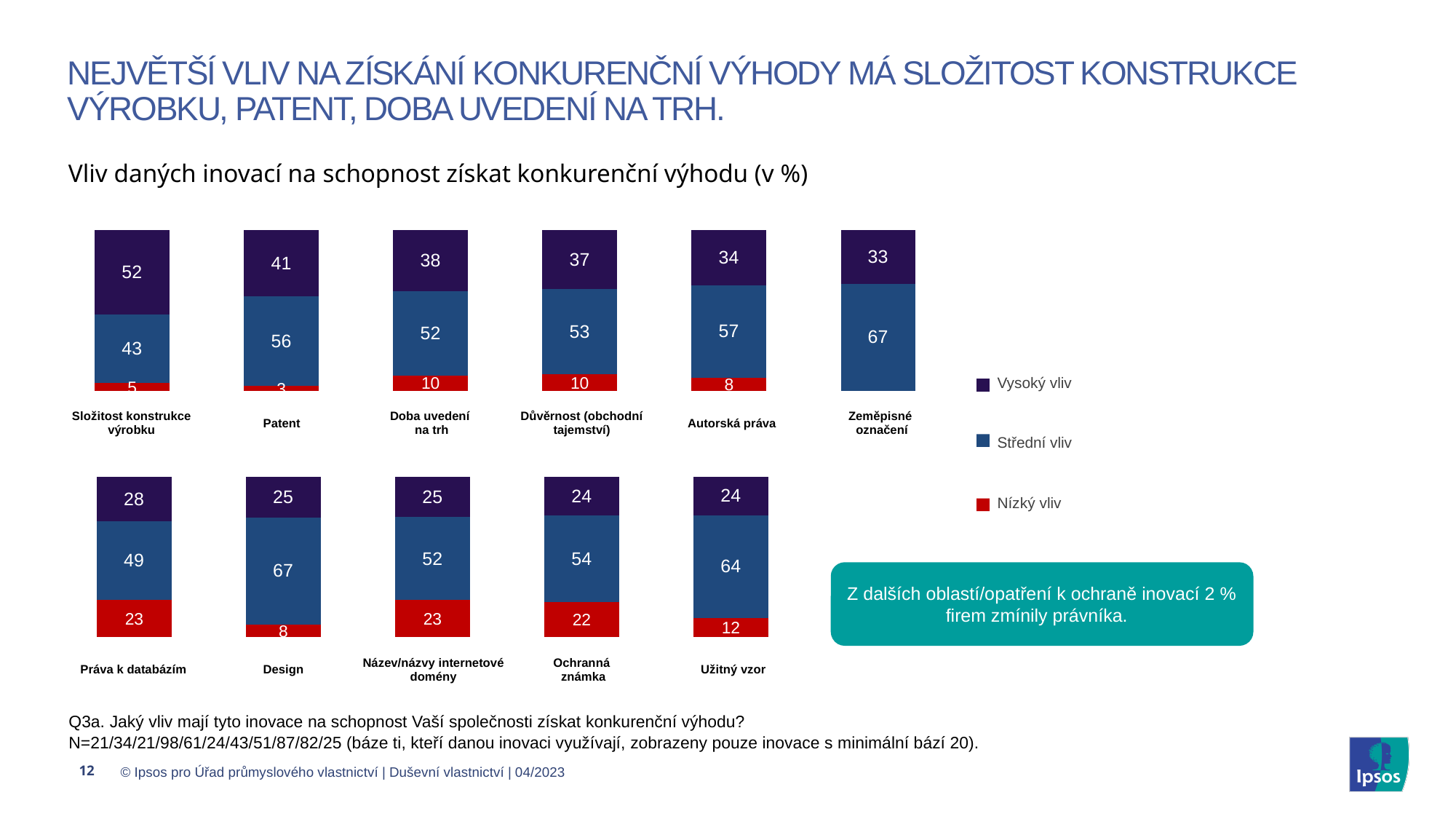
Which category has the highest 'Vysoký vliv' value? Složitost konstrukce výrobku What kind of chart is shown on the slide? Stacked bar chart What is the 'Vysoký vliv' value for Složitost konstrukce výrobku? 52 What is the total of the stacked bar for Ochranná známka? 100 Which is larger: the 'Střední vliv' value for Design or for Autorská práva? Design Which colour represents 'Nízký vliv' in the legend? Red How many series does the legend list? 3 What is the difference between the 'Vysoký vliv' values for Patent and Užitný vzor? 17 What is the 'Nízký vliv' value for Práva k databázím? 23 What is the 'Střední vliv' value for Zeměpisné označení? 67 Which category has the lowest 'Nízký vliv' value among those with a printed red segment? Patent How many categories (innovations) are shown in the chart? 11